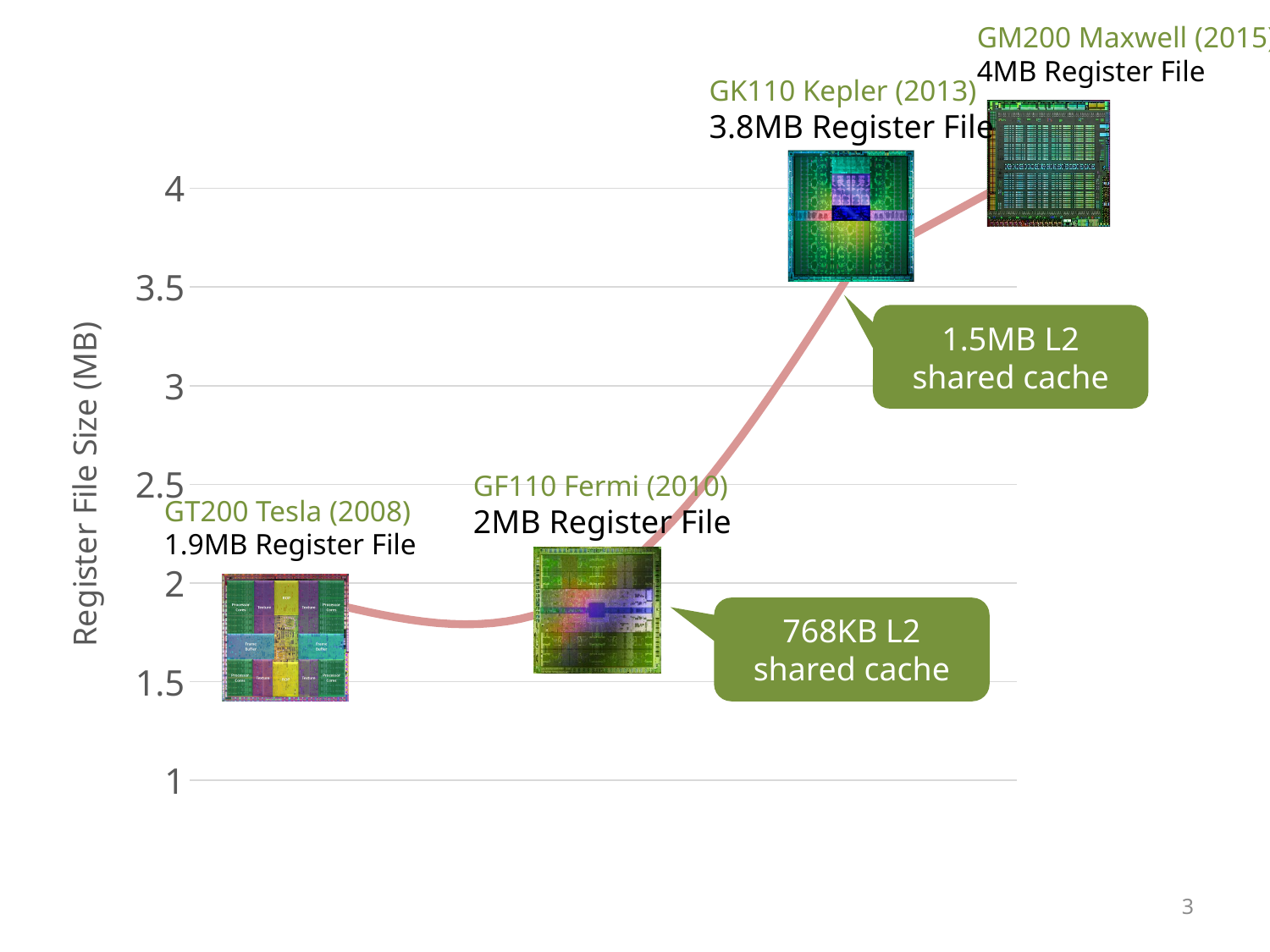
What is the difference in register file size between GK110 Kepler (2013) and GF110 Fermi (2010)? 1.8MB Is the register file size for GK110 Kepler (2013) greater or less than 3.5? greater Which has a larger register file, GK110 Kepler (2013) or GF110 Fermi (2010)? GK110 Kepler (2013) What is the label of the y axis? Register File Size (MB) What is the register file size for GT200 Tesla (2008)? 1.9MB What kind of chart is shown on the slide? line chart What is the register file size for GK110 Kepler (2013)? 3.8MB What is the register file size for GM200 Maxwell (2015)? 4MB Which GPU has the largest register file size? GM200 Maxwell (2015) How many GPUs are plotted on the chart? 4 What is the register file size for GF110 Fermi (2010)? 2MB Which GPU has the smallest register file size? GT200 Tesla (2008)